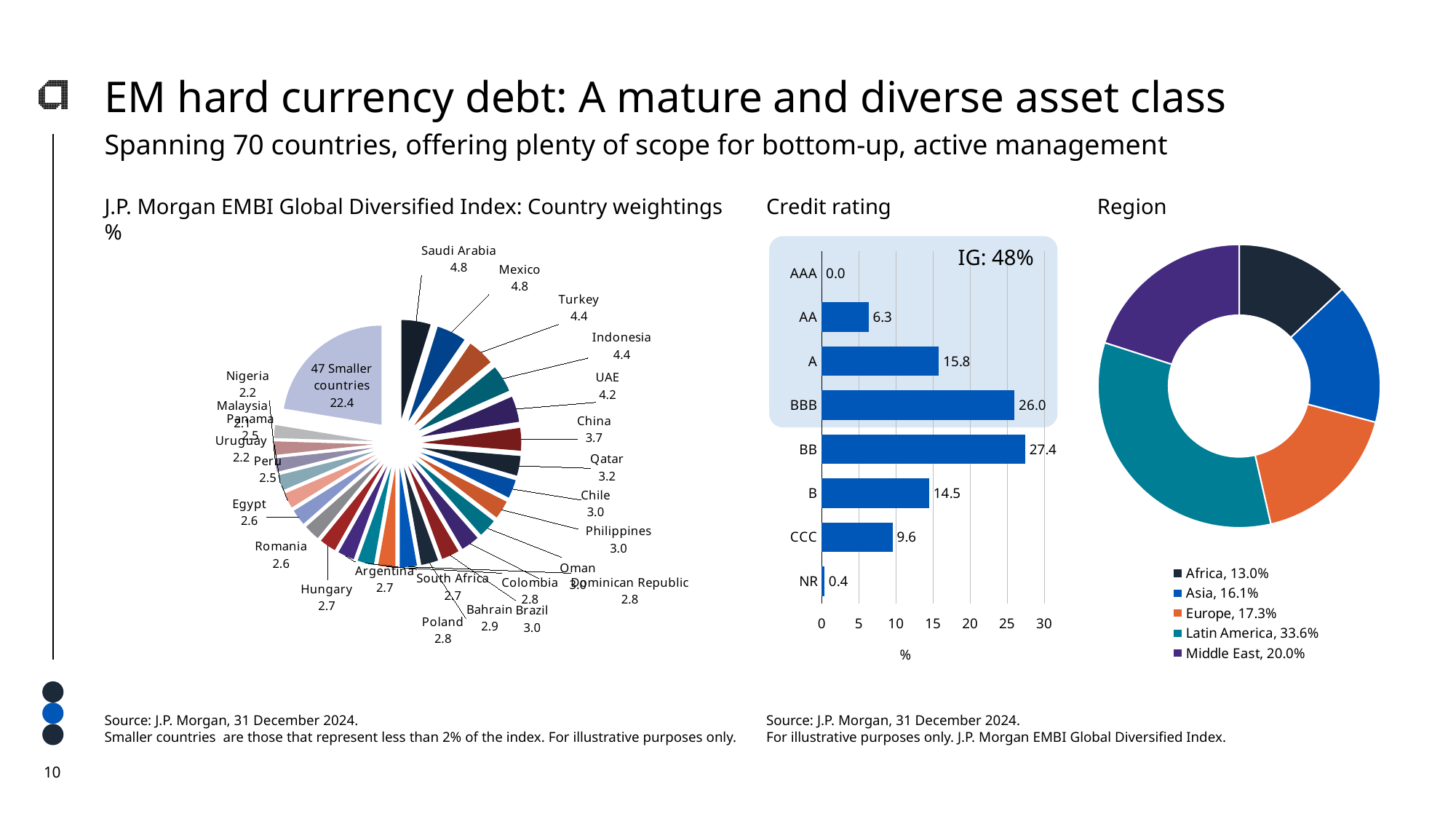
In the Region chart, which is larger, Europe or Asia? Europe In the J.P. Morgan EMBI Global Diversified Index country weightings chart, which has the larger weighting, Turkey or China? Turkey In the Credit rating chart, what investment-grade (IG) share is stated in the shaded box? 48% How many rating categories are shown in the Credit rating chart? 8 What kind of chart is the Credit rating chart? Bar chart In the J.P. Morgan EMBI Global Diversified Index country weightings chart, what is the weighting of the 47 smaller countries? 22.4 How many regions are listed in the legend of the Region chart? 5 In the Credit rating chart, what is the value for BBB? 26.0 In the Credit rating chart, which rating category has the highest value? BB In the Credit rating chart, what is the difference between the BB and BBB values? 1.4 In the Region chart, which region has the smallest share? Africa In the Region chart, what share does Latin America represent? 33.6%